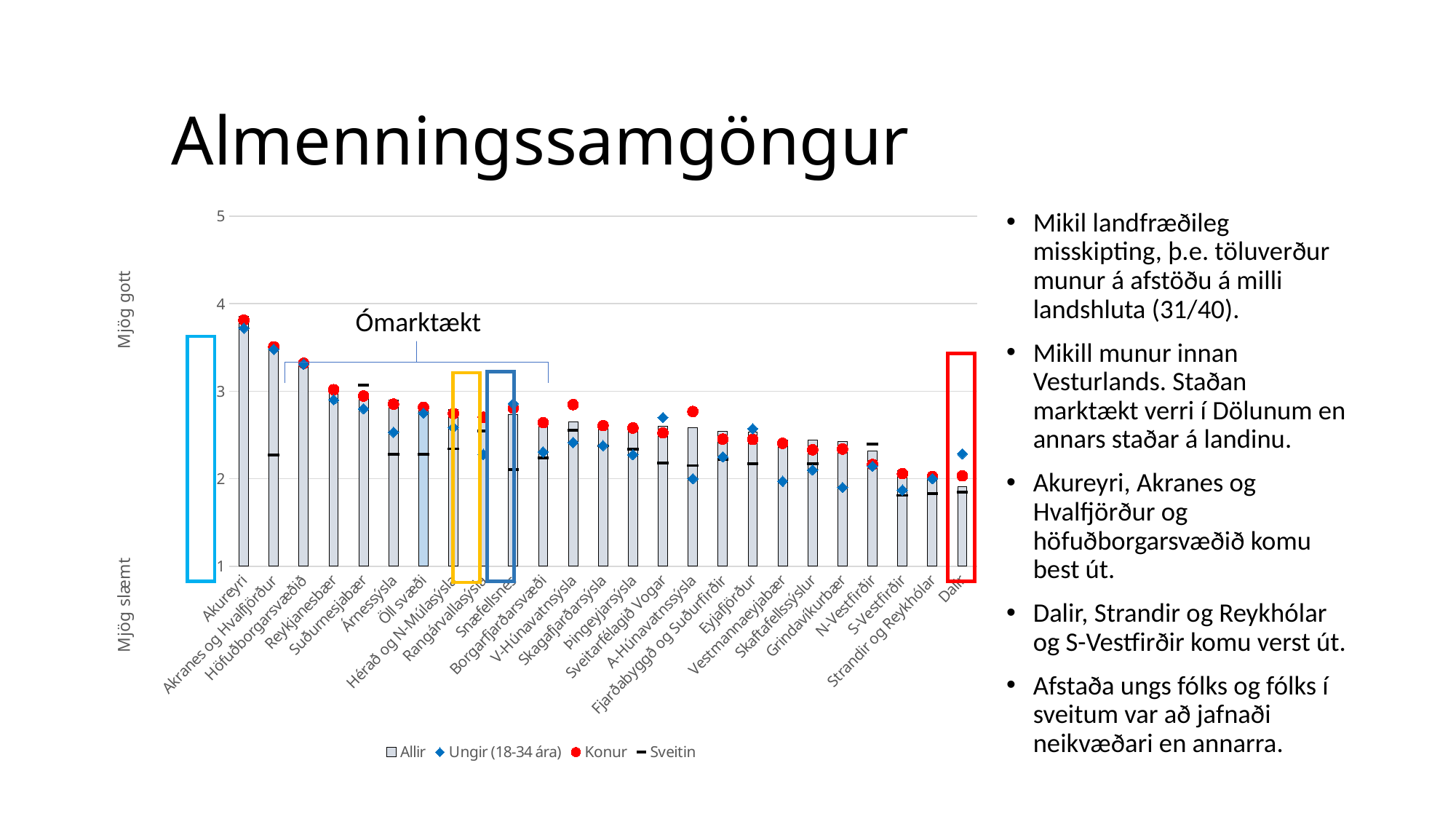
What is the title of the slide containing the chart? Almenningssamgöngur Do the Allir bars generally rise or fall from left to right along the x axis? fall Is the Allir value for Akureyri greater or less than 3? greater Which has the larger Allir value, Akureyri or Dalir? Akureyri What kind of chart is shown on the slide? bar chart How many series does the legend list? 4 Is the Ungir (18-34 ára) value for Dalir greater or less than 2? greater Is the Allir value for Dalir greater or less than 2? less Which category has the highest Allir bar? Akureyri How many categories are shown on the x axis of the chart? 25